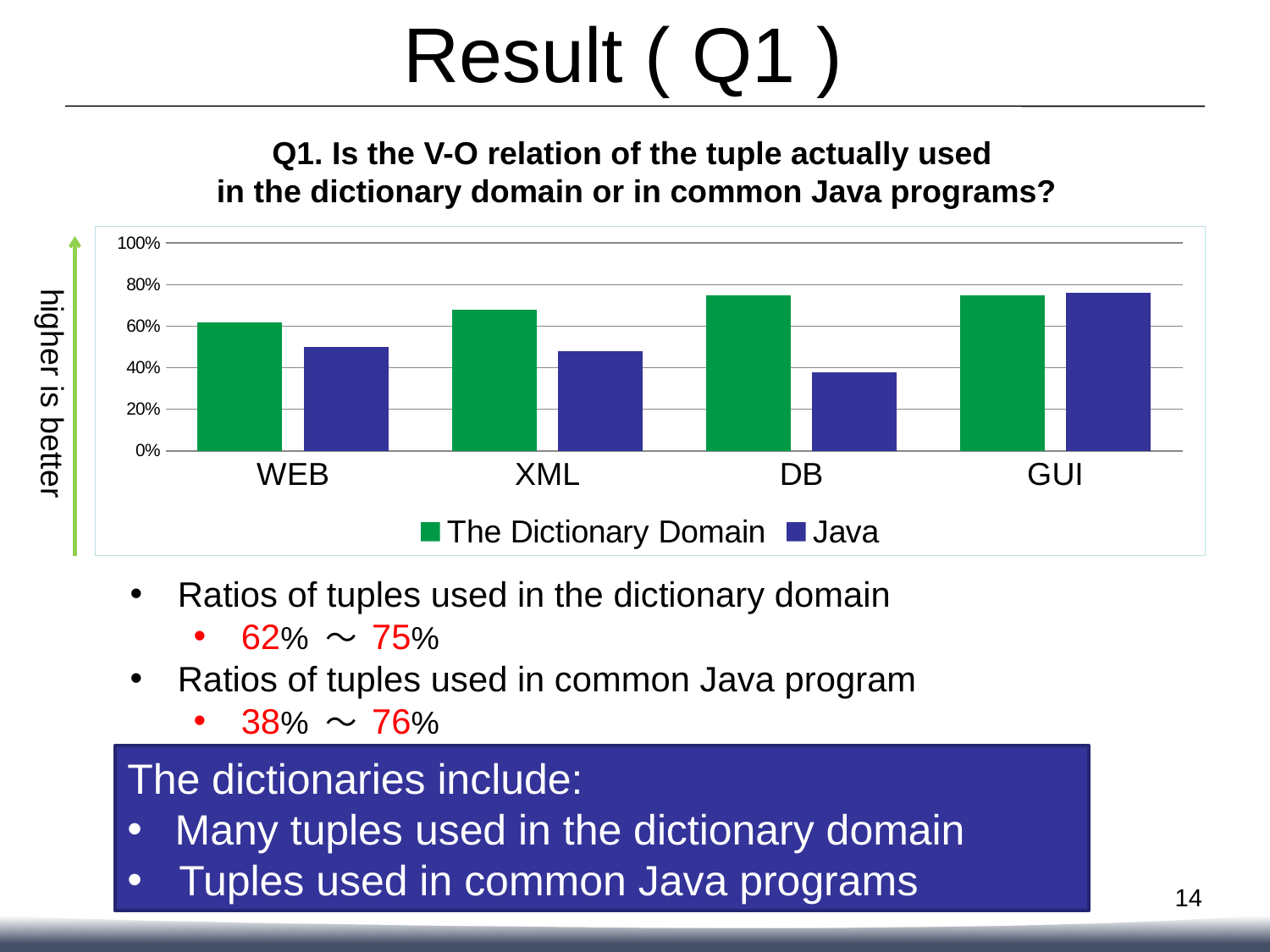
How many categories are shown on the x axis of the chart? 4 Is the value for The Dictionary Domain in the DB category greater or less than 60%? greater Which category has the lowest value for the Java series? DB What kind of chart is shown on the slide? bar chart For the WEB category, which series has the larger value, The Dictionary Domain or Java? The Dictionary Domain What are the two series named in the chart legend? The Dictionary Domain and Java For the DB category, which series has the larger value, The Dictionary Domain or Java? The Dictionary Domain Which category has the highest value for the Java series? GUI Is the value for Java in the XML category greater or less than 60%? less How many series does the chart legend list? 2 Which colour represents the Java series in the chart? blue Is the value for Java in the GUI category greater or less than 60%? greater